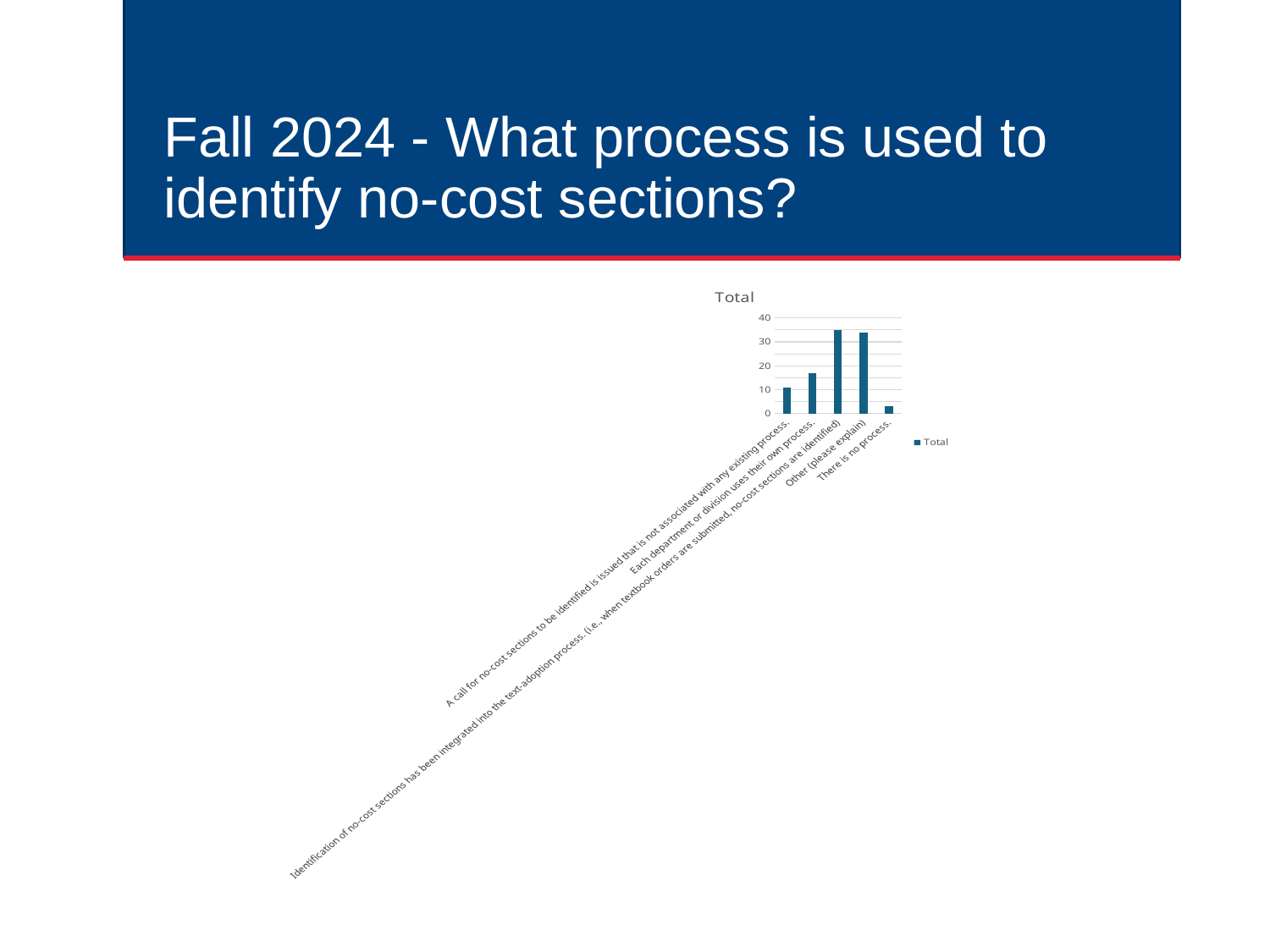
Is the value for "There is no process." greater or less than 10? less Is the value for "Other (please explain)" greater or less than 30? greater How many series does the chart's legend list? 1 How many categories are plotted on the x axis of the chart? 5 What kind of chart is shown on the slide? bar chart What is the name of the series shown in the chart's legend? Total Which has the larger value: "Each department or division uses their own process." or "There is no process."? Each department or division uses their own process. What is the title of the chart? Total Is the value for "Identification of no-cost sections has been integrated into the text-adoption process." greater or less than 30? greater Which category has the lowest value in the chart? There is no process. Which has the larger value: "A call for no-cost sections to be identified is issued that is not associated with any existing process." or "Other (please explain)"? Other (please explain)